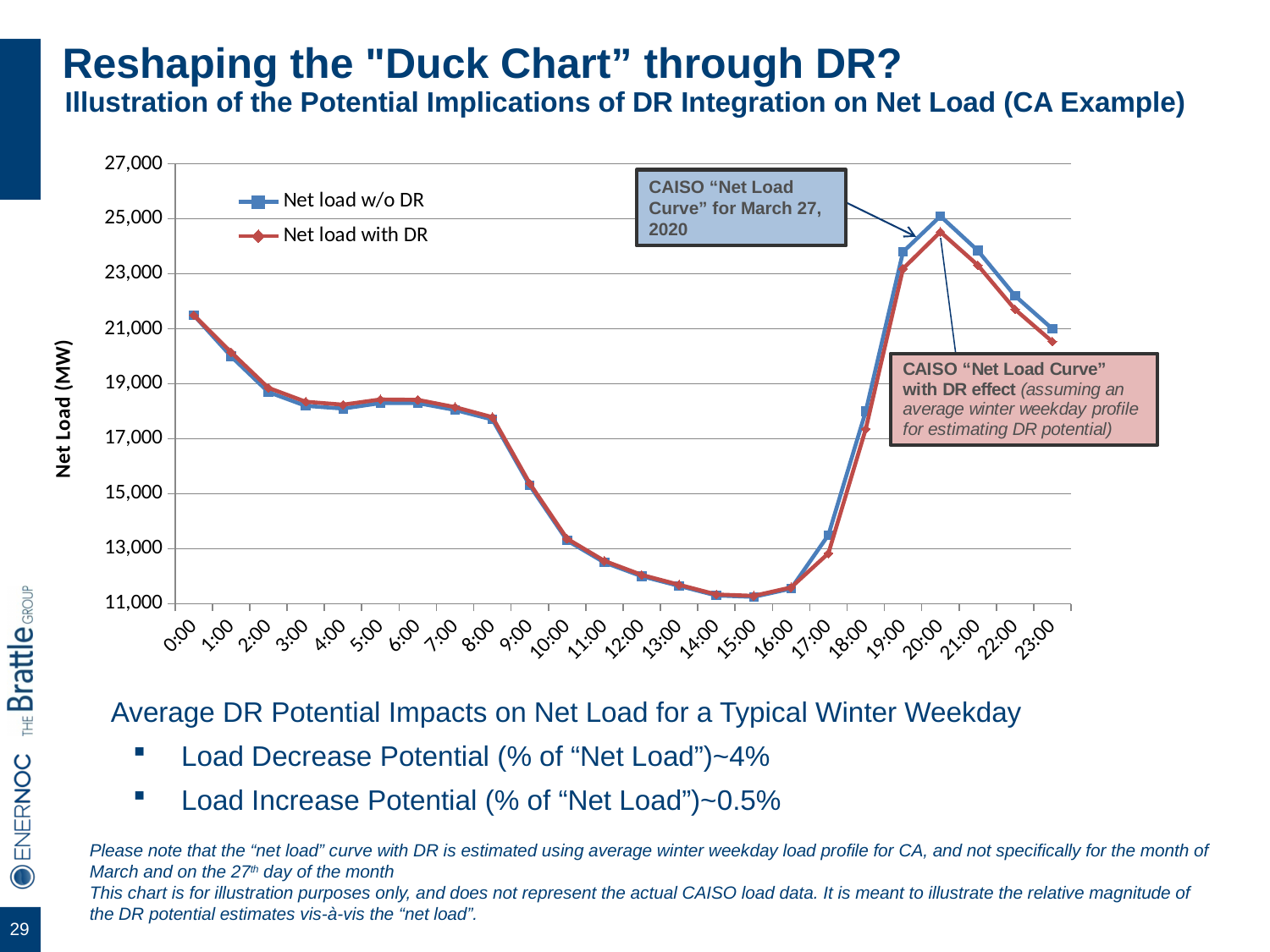
What is the title of the y axis? Net Load (MW) Is the value for Net load w/o DR at 0:00 greater or less than 19,000? greater At which hour does the Net load w/o DR series reach its highest value? 20:00 How many hourly points are plotted along the x axis? 24 Is the value for Net load w/o DR at 20:00 greater or less than 23,000? greater How many series does the chart legend list? 2 What kind of chart is shown on the slide? line chart Is the value for Net load w/o DR at 12:00 greater or less than 13,000? less At 20:00, which series has the higher value: Net load w/o DR or Net load with DR? Net load w/o DR Do the net load values rise or fall between 15:00 and 20:00? rise At which hour does the Net load w/o DR series reach its lowest value? 15:00